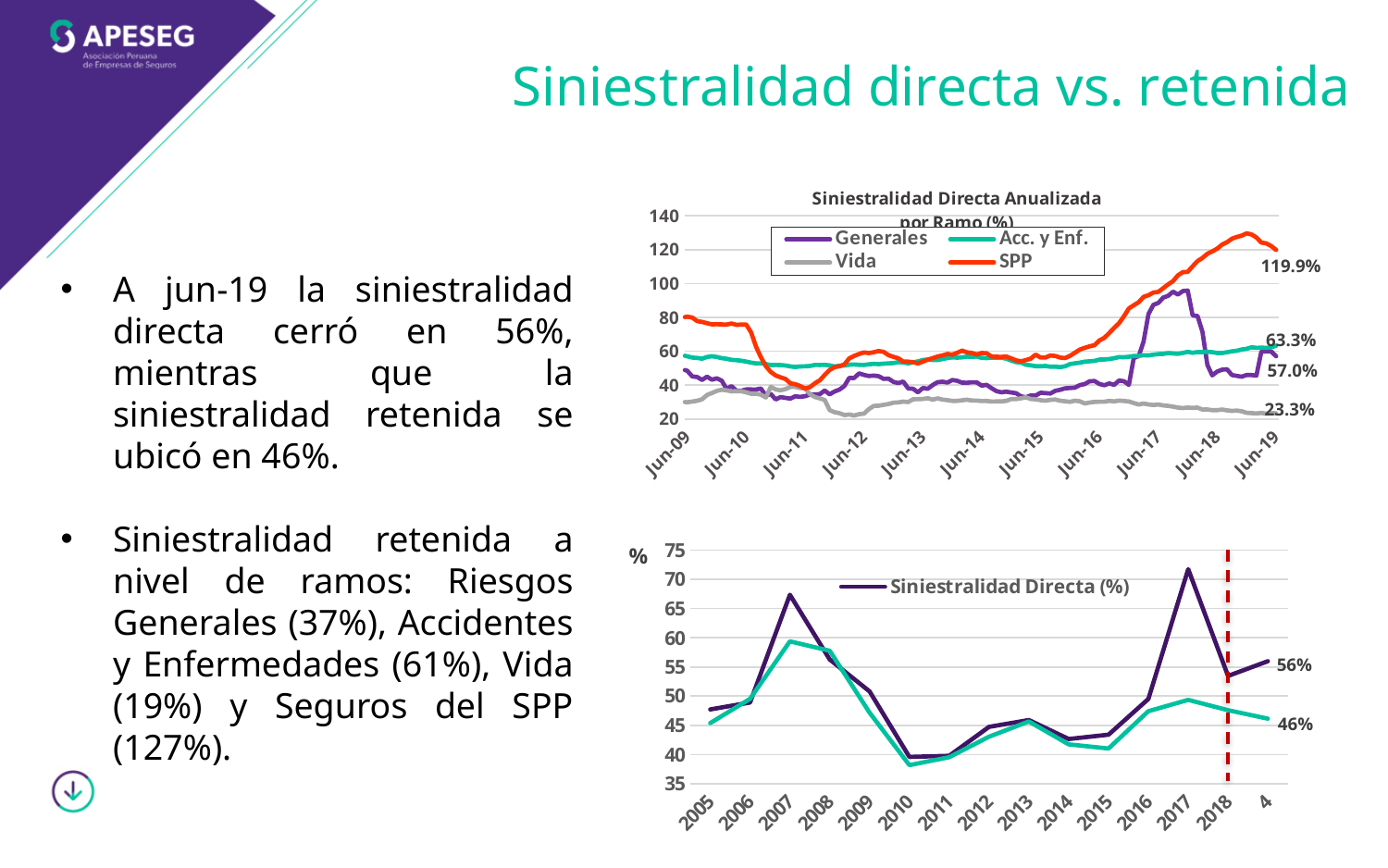
What kind of chart is the bottom chart? Line chart In the top chart, what is the final labelled value for the Vida series? 23.3% In the top chart, what is the final labelled value for the Acc. y Enf. series? 63.3% How many series does the legend of the top chart list? 4 In the bottom chart, is the value of the purple line in 2017 greater or less than 70? greater In the top chart, which series has the highest value at the end of the period? SPP In the bottom chart, what is the final labelled value of the purple line? 56% In the top chart, what is the final labelled value for the Generales series? 57.0% In the top chart, is the value for SPP at Jun-11 greater or less than 60? less In the top chart, what is the final labelled value for the SPP series? 119.9% In the top chart, which series has the lowest value at the end of the period? Vida In the top chart, what is the difference between the final labelled values of SPP and Vida? 96.6%